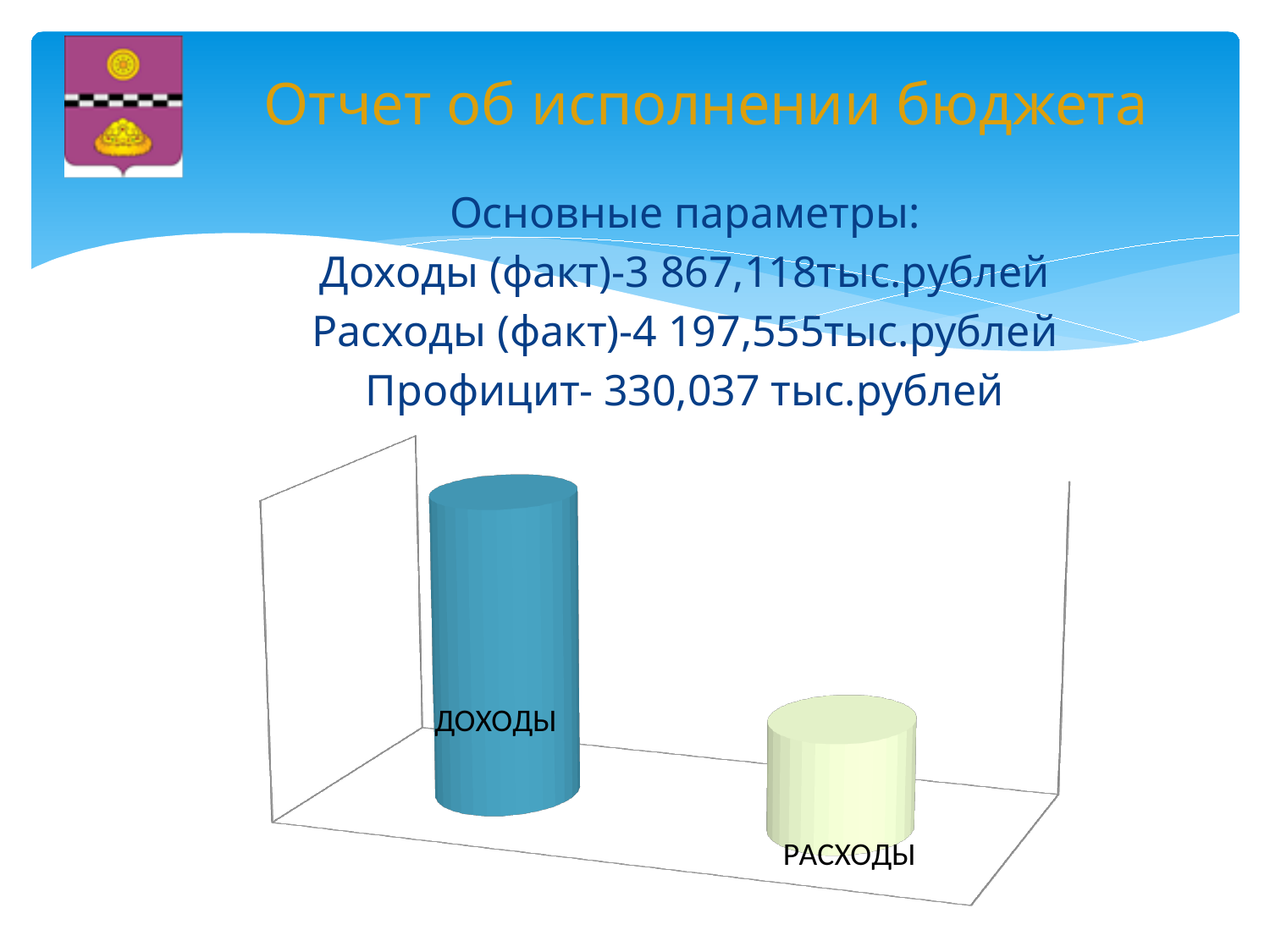
Which category has the tallest bar in the chart? ДОХОДЫ What are the two category labels shown on the chart? ДОХОДЫ and РАСХОДЫ What kind of chart is shown on the slide? bar chart How many bars does the chart show? 2 Which category has the shortest bar in the chart? РАСХОДЫ What colour is the ДОХОДЫ bar in the chart? blue Which bar is taller in the chart, ДОХОДЫ or РАСХОДЫ? ДОХОДЫ